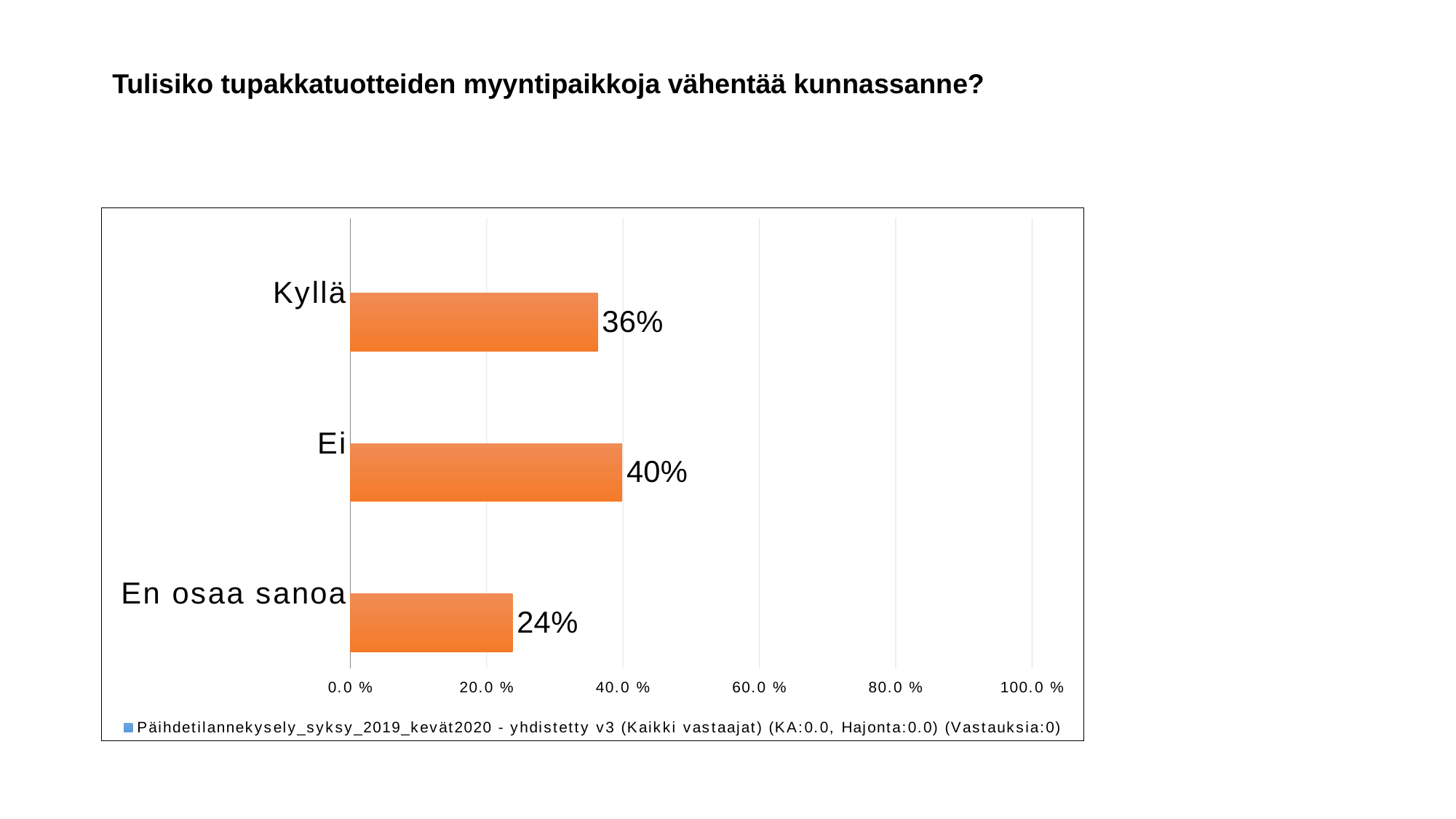
What is the difference between the values for Kyllä and En osaa sanoa? 12% What is the value for En osaa sanoa? 24% What is the title of the slide? Tulisiko tupakkatuotteiden myyntipaikkoja vähentää kunnassanne? What is the difference between the values for Ei and Kyllä? 4% What kind of chart is shown on the slide? bar chart What is the value for Kyllä? 36% Is the value for Kyllä greater or less than 20.0 %? greater Which is larger, the value for Kyllä or the value for En osaa sanoa? Kyllä What is the value for Ei? 40% Which category has the lowest value? En osaa sanoa How many categories are shown in the chart? 3 Which category has the highest value? Ei